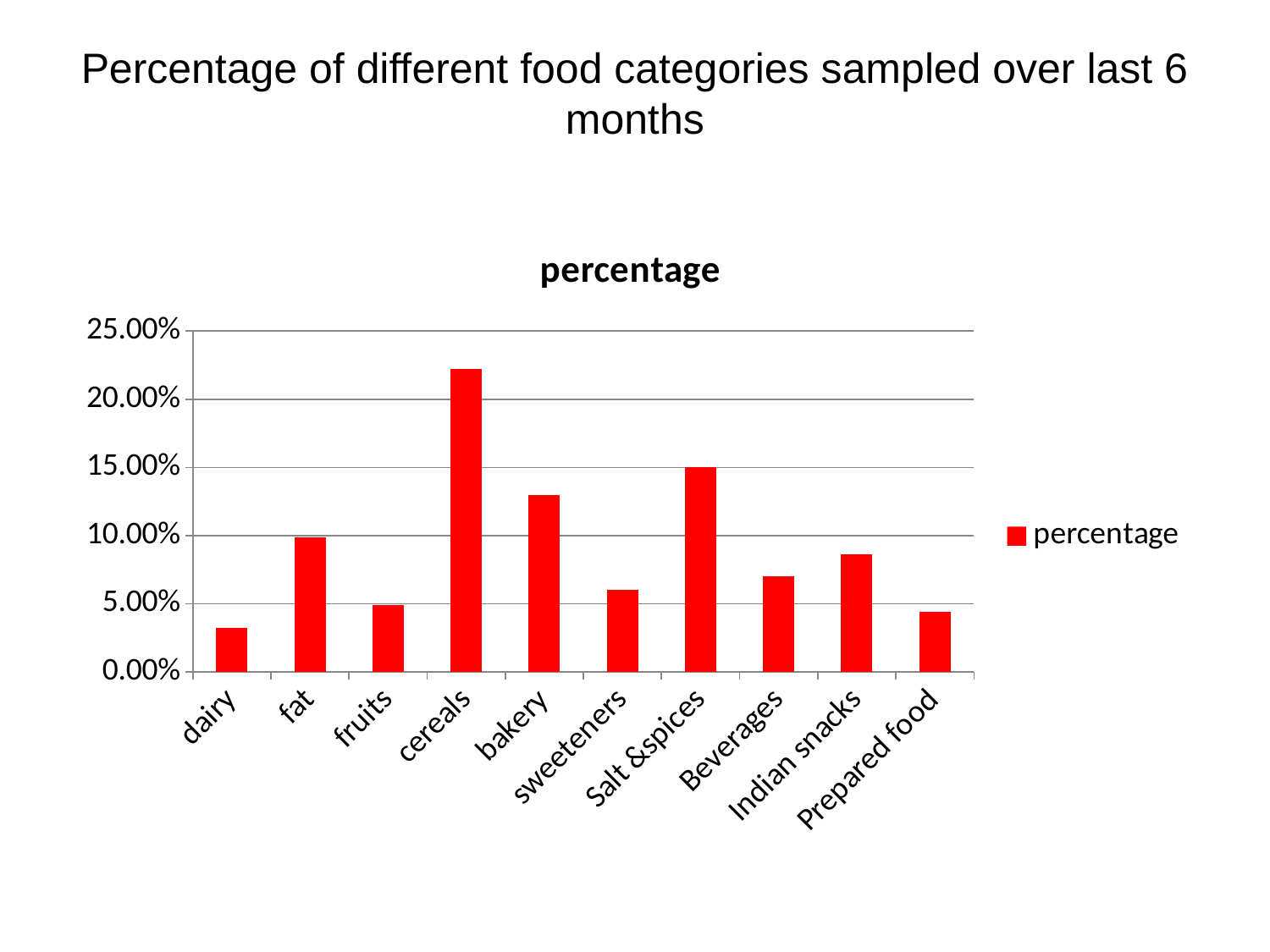
What colour are the bars in the chart? red Is the value for cereals greater or less than 20.00%? greater Which food category has the highest percentage? cereals How many food categories are plotted on the chart? 10 What is the title shown above the chart? percentage Is the value for Indian snacks greater or less than 5.00%? greater How many series does the legend list? 1 Is the value for dairy greater or less than 5.00%? less Which has a higher percentage, fat or fruits? fat What kind of chart is shown on the slide? bar chart Which food category has the lowest percentage? dairy Which has a higher percentage, bakery or Beverages? bakery